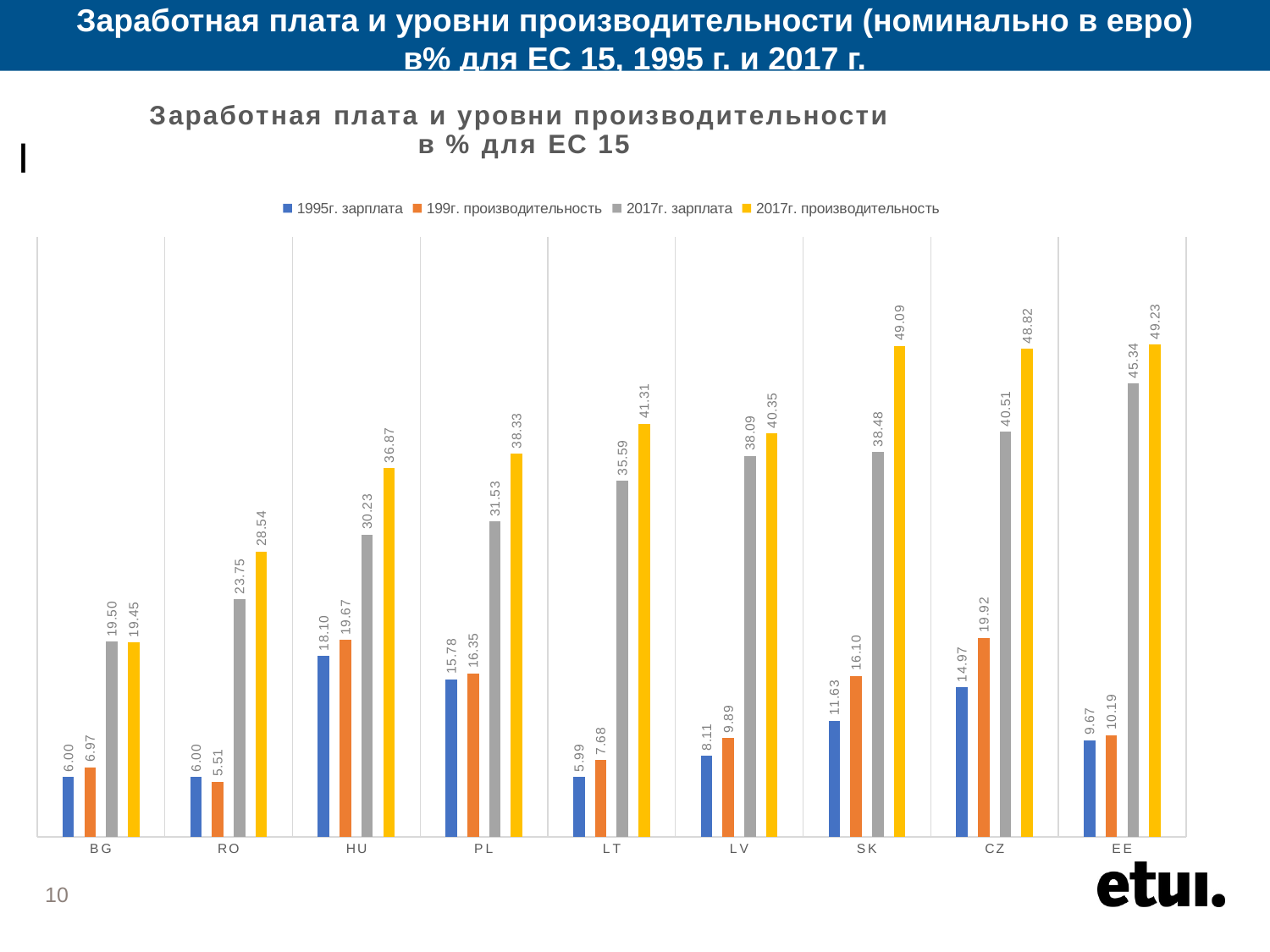
What kind of chart is shown? Bar chart Which country has the highest value for 2017г. зарплата? EE What is the value of 2017г. производительность for SK? 49.09 How many series does the legend list? 4 How many countries are shown on the x axis? 9 Which is larger: 1995г. зарплата for HU or for PL? HU Which country has the highest value for 1995г. зарплата? HU Which country has the lowest value for 2017г. производительность? BG What is the value of 1995г. зарплата for HU? 18.10 What is the difference between 2017г. производительность and 2017г. зарплата for CZ? 8.31 What is the value of 199г. производительность for RO? 5.51 What is the value of 2017г. зарплата for LT? 35.59